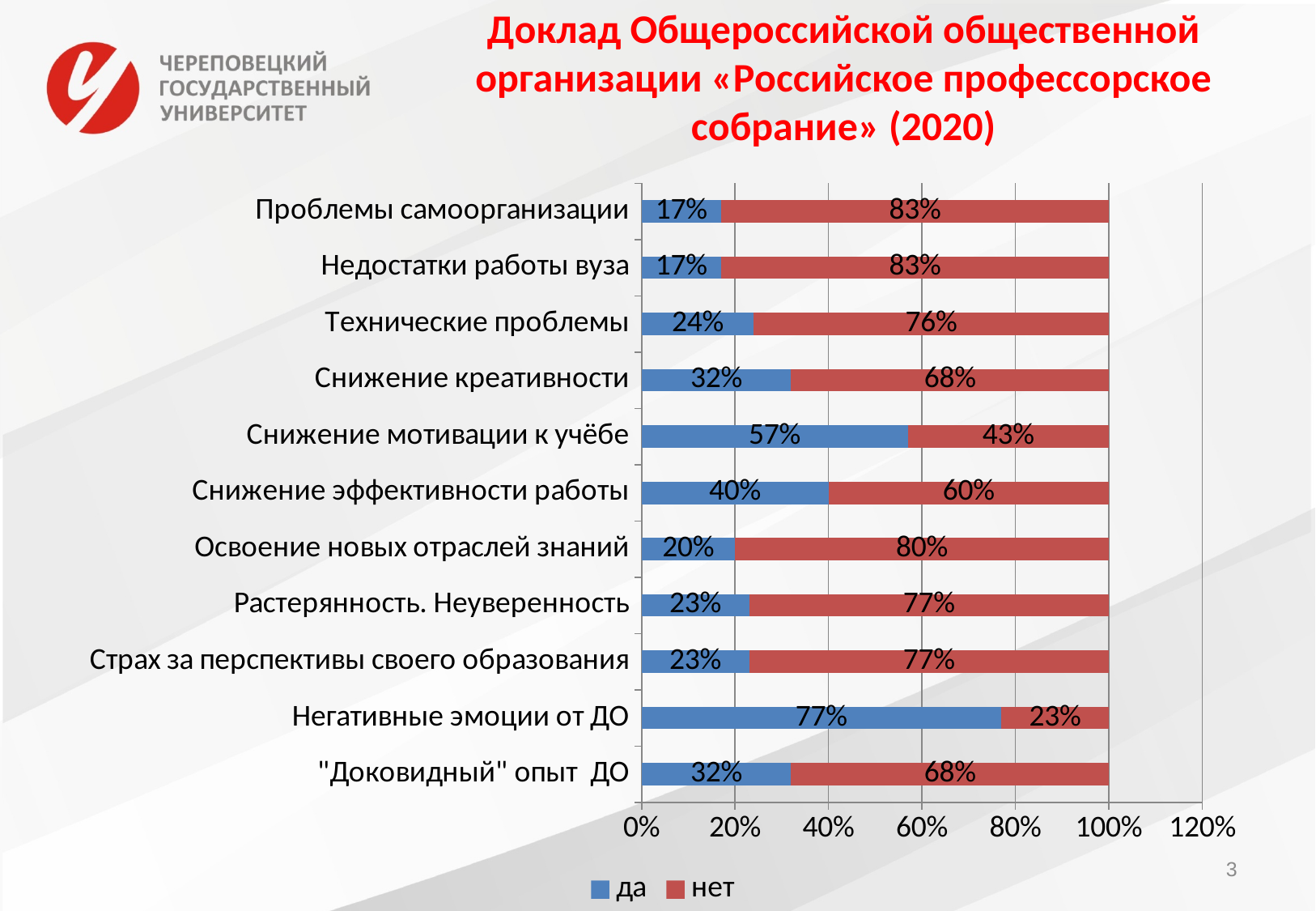
What is the "да" value for "Снижение мотивации к учёбе"? 57% What is the "нет" value for "Технические проблемы"? 76% Which category has the lowest "нет" value? Негативные эмоции от ДО How many series does the legend list? 2 Which category has the highest "да" value? Негативные эмоции от ДО What type of chart is shown on the slide? stacked bar chart What is the total of the stacked bar for "Проблемы самоорганизации"? 100% How many categories are plotted in the chart? 11 What is the difference between the "нет" and "да" values for "Снижение эффективности работы"? 20% What are the two legend entries of the chart? да, нет Which is larger: the "да" value for "Снижение креативности" or the "да" value for "Освоение новых отраслей знаний"? Снижение креативности What is the "да" value for "Негативные эмоции от ДО"? 77%